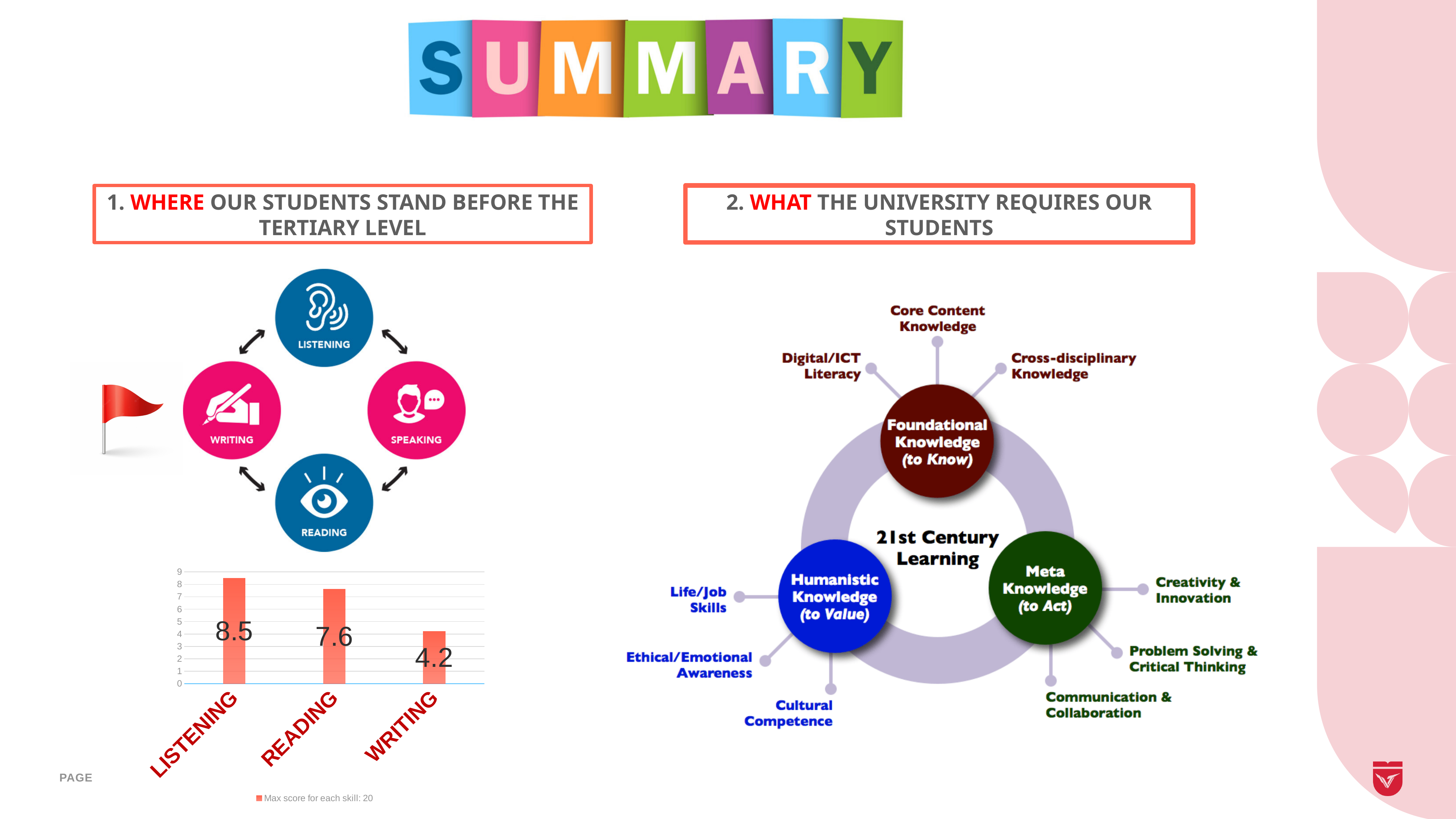
How many skill categories are shown in the bar chart? 3 Which is larger in the bar chart, the value for READING or the value for WRITING? READING Which skill has the lowest value in the bar chart? WRITING What kind of chart is used to show the skill scores? bar chart What is the value for LISTENING in the bar chart? 8.5 What is the value for WRITING in the bar chart? 4.2 What is the difference between the LISTENING and WRITING values in the bar chart? 4.3 Which skill has the highest value in the bar chart? LISTENING What does the legend of the bar chart say? Max score for each skill: 20 What is the difference between the LISTENING and READING values in the bar chart? 0.9 What is the value for READING in the bar chart? 7.6 Is the value for WRITING in the bar chart greater or less than 5? less